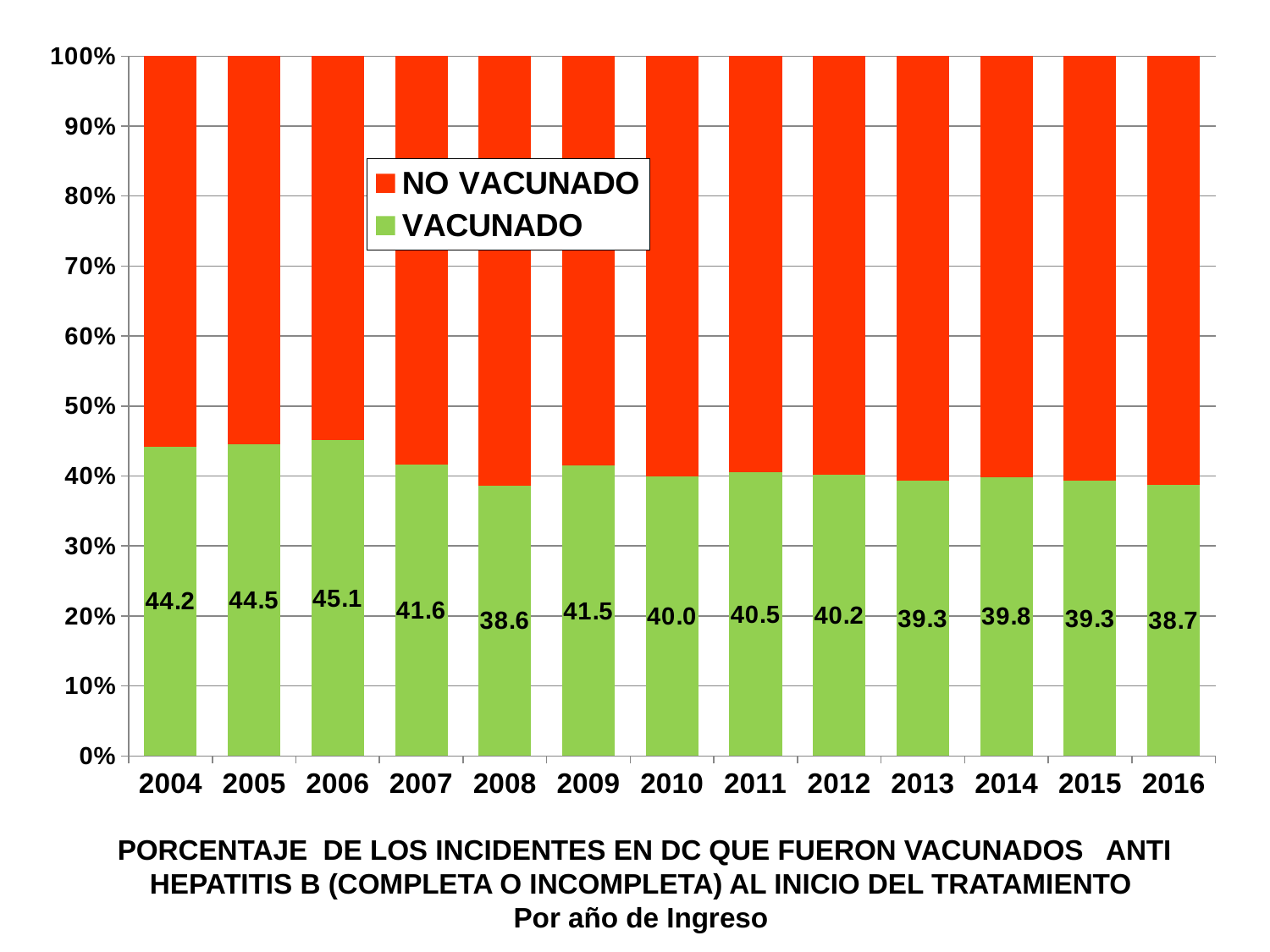
Which year has the lowest VACUNADO value? 2008 Which year has the highest VACUNADO value? 2006 Which year has a larger VACUNADO value, 2005 or 2013? 2005 What is the VACUNADO value for 2004? 44.2 What is the VACUNADO value for 2016? 38.7 Is the NO VACUNADO share for 2006 greater or less than 50%? greater What kind of chart is shown on the slide? Stacked bar chart How many years are shown on the x axis? 13 What is the difference between the VACUNADO values for 2004 and 2016? 5.5 What is the VACUNADO value for 2010? 40.0 How many series does the legend list? 2 What is the difference between the VACUNADO values for 2006 and 2008? 6.5